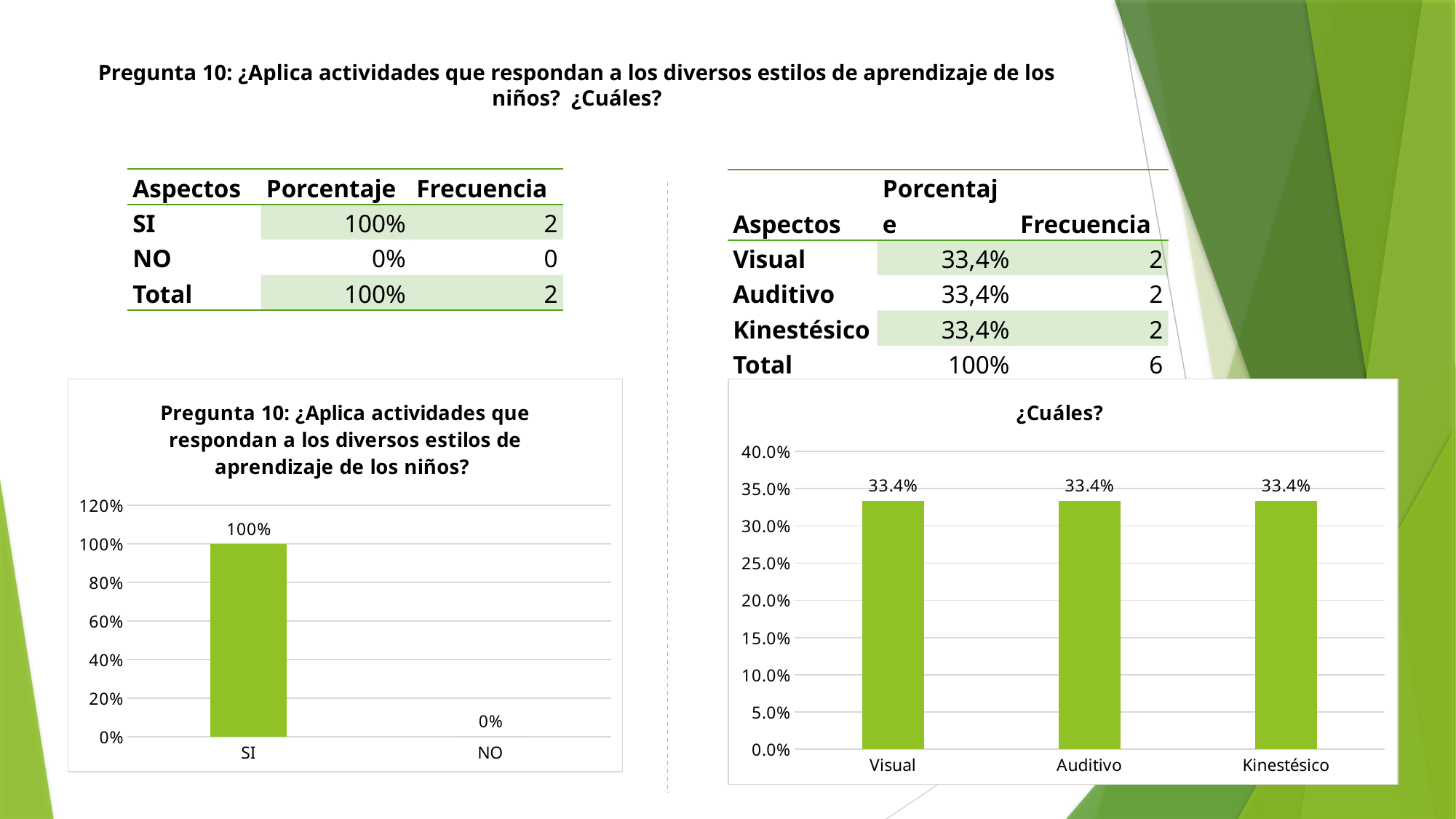
In the right chart (¿Cuáles?), is the value for Auditivo greater or less than 30.0%? greater In the right chart (¿Cuáles?), what is the highest value shown on the y axis? 40.0% What kind of chart is the left chart (Pregunta 10)? bar chart In the left chart (Pregunta 10), how many categories are shown on the x axis? 2 What is the title of the right chart? ¿Cuáles? In the left chart (Pregunta 10), what is the value for SI? 100% In the left chart (Pregunta 10), which category has the highest value? SI In the right chart (¿Cuáles?), what is the value for Kinestésico? 33.4% In the right chart (¿Cuáles?), what is the value for Visual? 33.4% In the left chart (Pregunta 10), what is the difference between the values for SI and NO? 100% In the right chart (¿Cuáles?), how many categories are shown on the x axis? 3 In the left chart (Pregunta 10), what is the value for NO? 0%